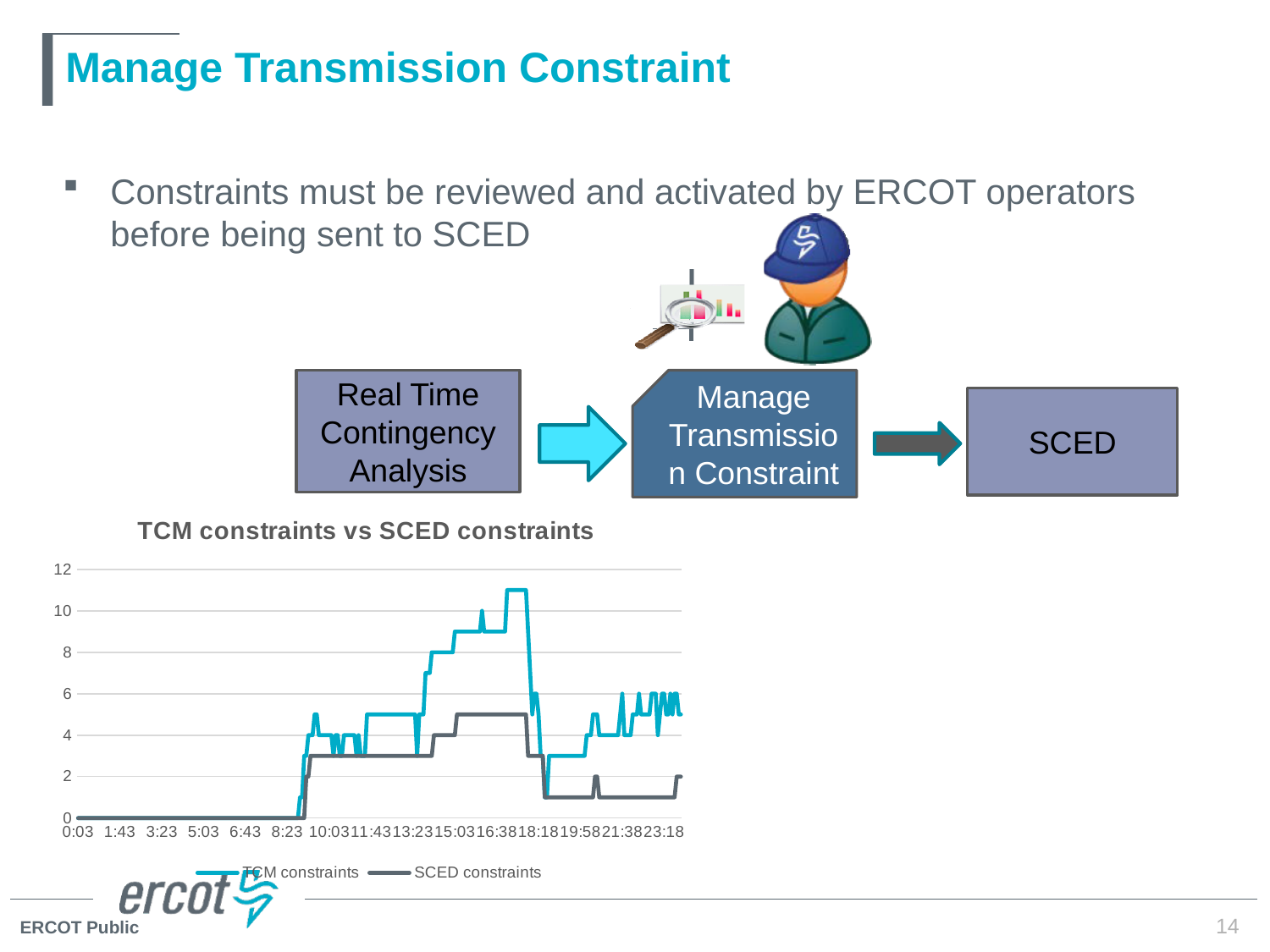
Is the peak value of SCED constraints greater or less than 6? less Is the value of SCED constraints at 23:18 greater or less than 4? less Is the value of TCM constraints at 16:38 greater or less than 8? greater What is the highest value shown on the y axis of the chart? 12 What is the title of the chart on the slide? TCM constraints vs SCED constraints What is the value of TCM constraints at 0:03? 0 What kind of chart is shown on the slide? line chart How many series does the chart legend list? 2 Which series reaches the higher peak value, TCM constraints or SCED constraints? TCM constraints Which series is drawn in the light blue (cyan) colour? TCM constraints Do the TCM constraints generally rise or fall between 8:23 and 16:38? rise